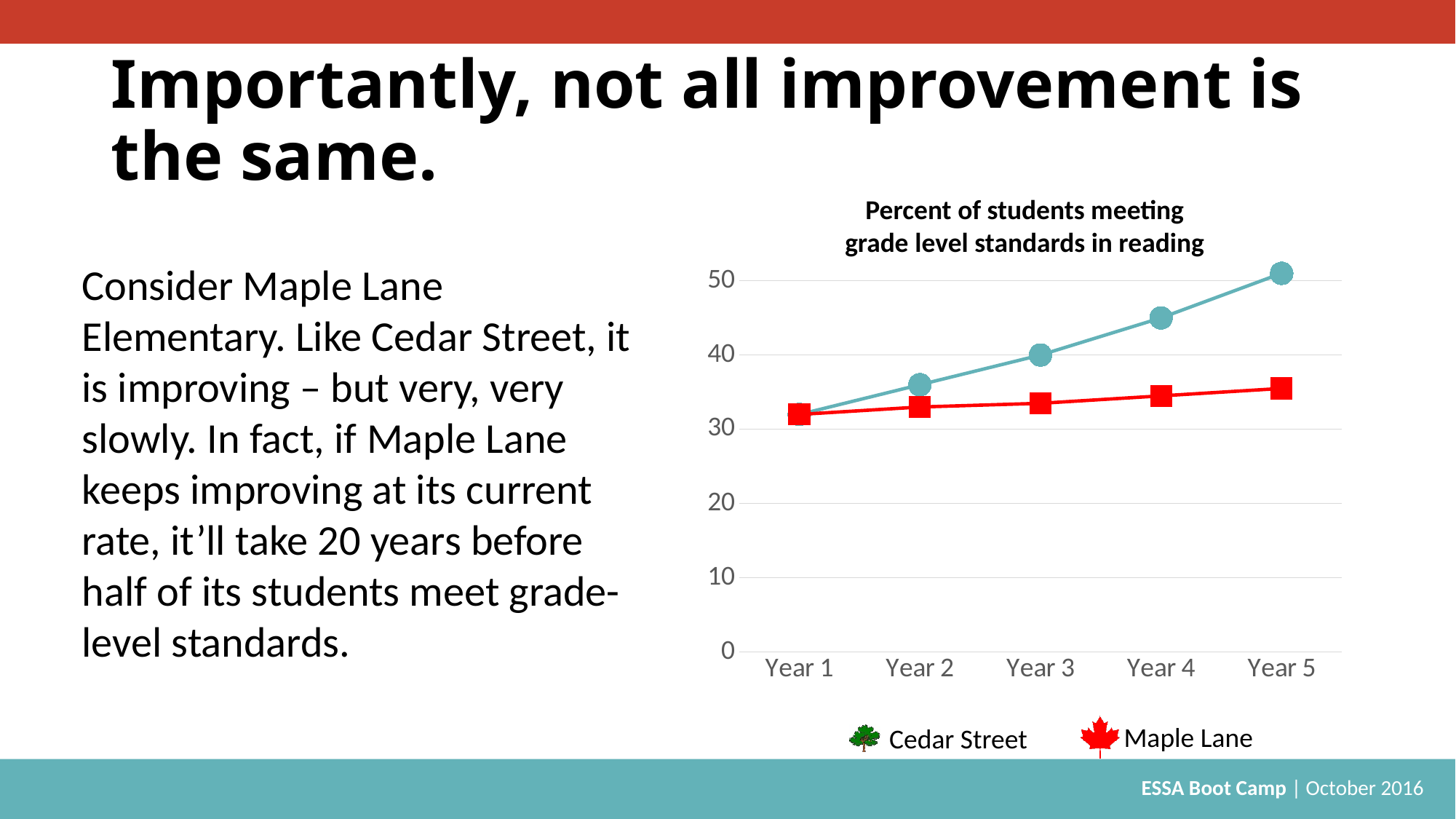
In which year is the value for Cedar Street highest? Year 5 How many years are plotted along the x axis of the chart? 5 Which series is drawn with red square markers? Maple Lane In Year 5, which series has the larger value, Cedar Street or Maple Lane? Cedar Street Do the values for Cedar Street rise or fall from Year 1 to Year 5? rise What kind of chart is shown on the slide? line chart How many series does the chart's legend list? 2 Is the value for Cedar Street in Year 4 greater or less than 40? greater Is the value for Maple Lane in Year 3 greater or less than 30? greater What is the title of the chart? Percent of students meeting grade level standards in reading In which year is the value for Maple Lane lowest? Year 1 Is the value for Maple Lane in Year 5 greater or less than 40? less